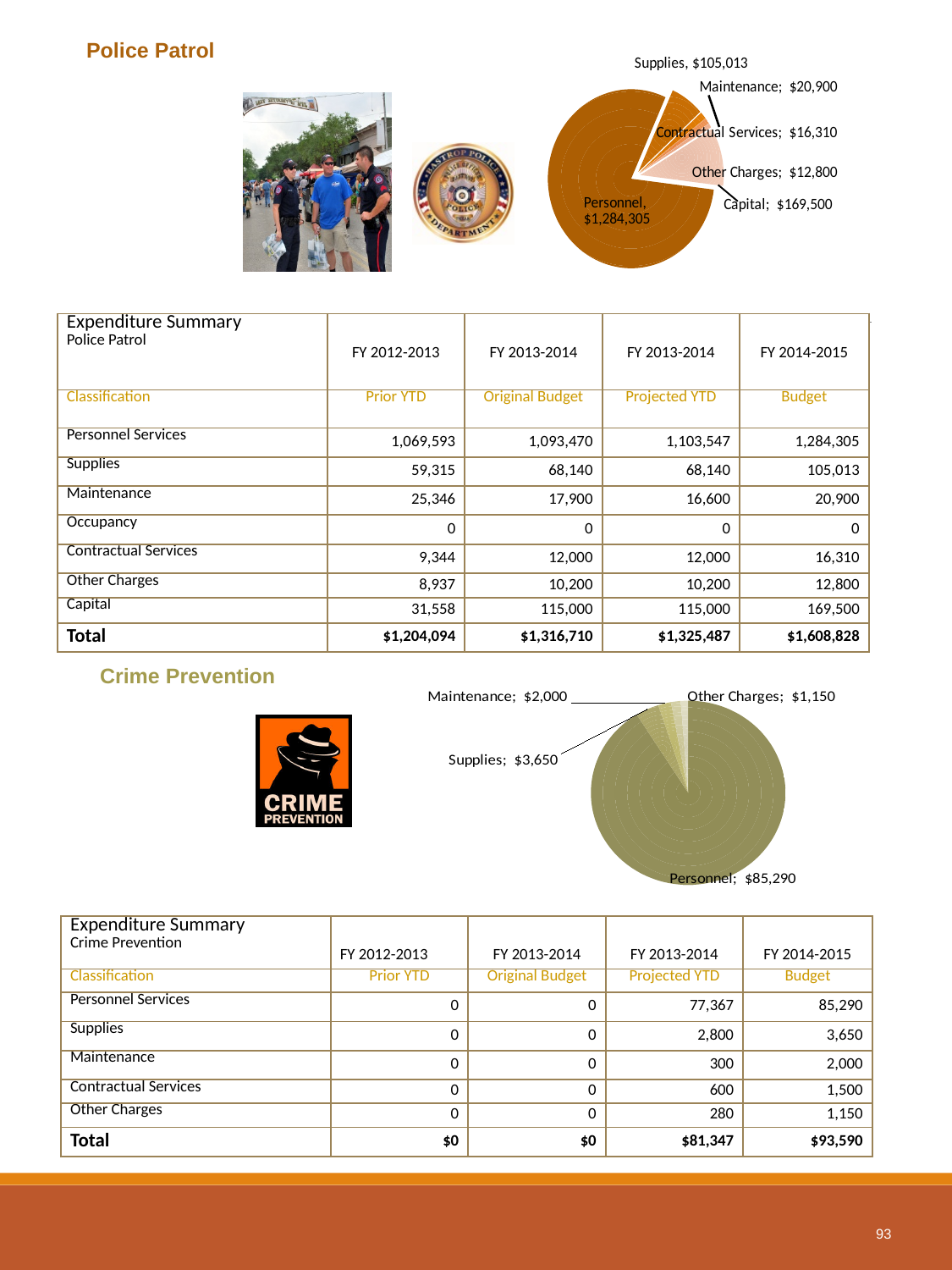
In the Crime Prevention pie chart, what is the value for Supplies? $3,650 In the Police Patrol pie chart, which category has the smallest slice? Other Charges In the Police Patrol pie chart, which is larger, Maintenance or Contractual Services? Maintenance In the Police Patrol pie chart, what is the difference between Capital and Supplies? $64,487 How many slices are labeled in the Police Patrol pie chart? 6 What type of chart is used for the Police Patrol expenditures? Pie chart In the Police Patrol pie chart, what is the value for Personnel? $1,284,305 In the Crime Prevention pie chart, what is the value for Personnel? $85,290 In the Police Patrol pie chart, what is the value for Capital? $169,500 In the Crime Prevention pie chart, what is the difference between Supplies and Maintenance? $1,650 In the Crime Prevention pie chart, which is larger, Maintenance or Other Charges? Maintenance In the Police Patrol pie chart, which category has the largest slice? Personnel